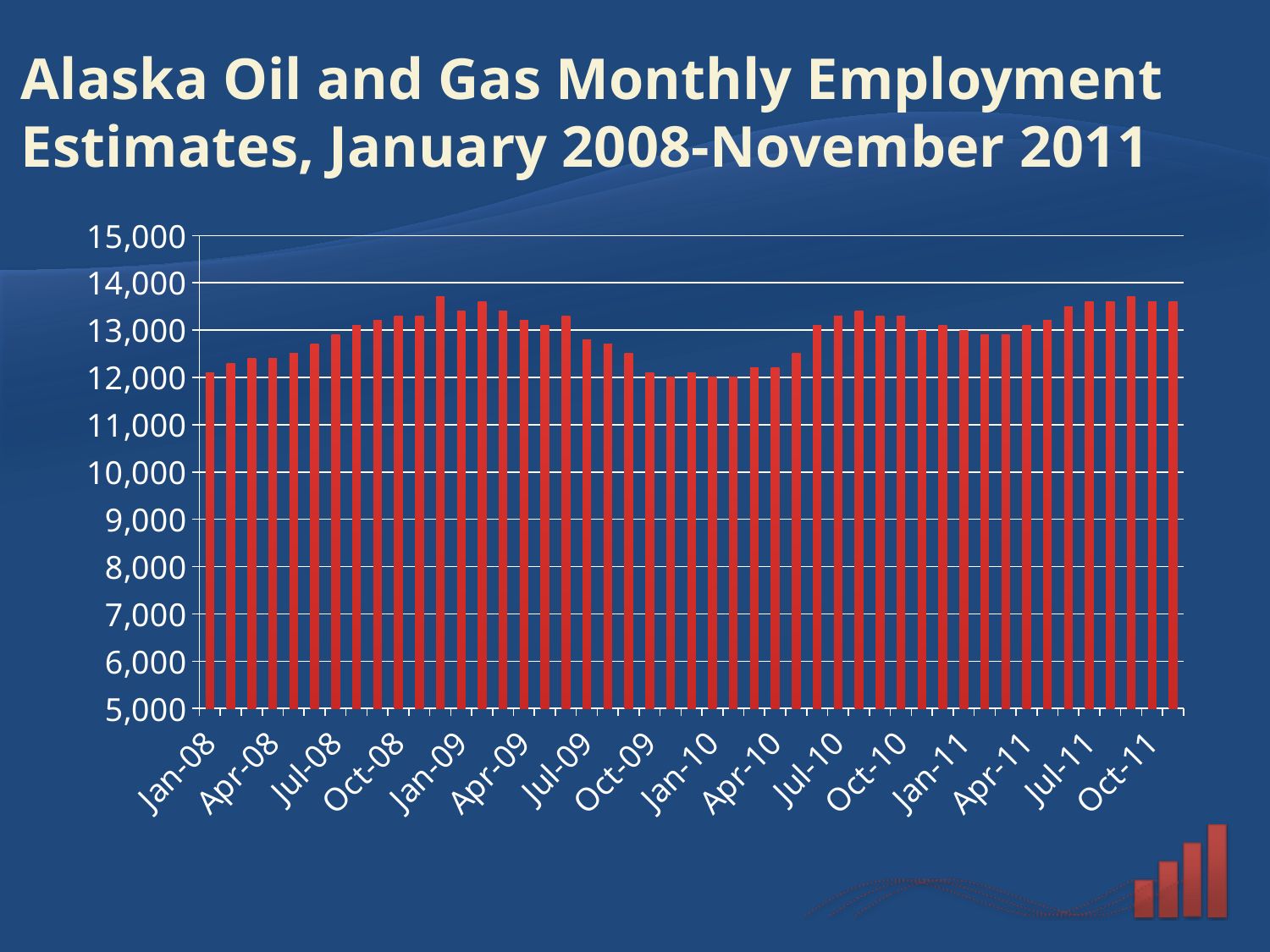
What kind of chart is shown on the slide? bar chart Is the value for Oct-11 greater or less than 13,000? greater What is the title of the chart? Alaska Oil and Gas Monthly Employment Estimates, January 2008-November 2011 Which is larger, the value for Jan-09 or the value for Oct-09? Jan-09 Is the value for Apr-10 greater or less than 13,000? less Is the value for Jan-09 greater or less than 13,000? greater Which is larger, the value for Apr-10 or the value for Oct-10? Oct-10 How many month labels are shown on the x axis? 16 Do the values generally rise or fall from Jan-09 to Jan-10? fall What colour are the bars in the chart? red